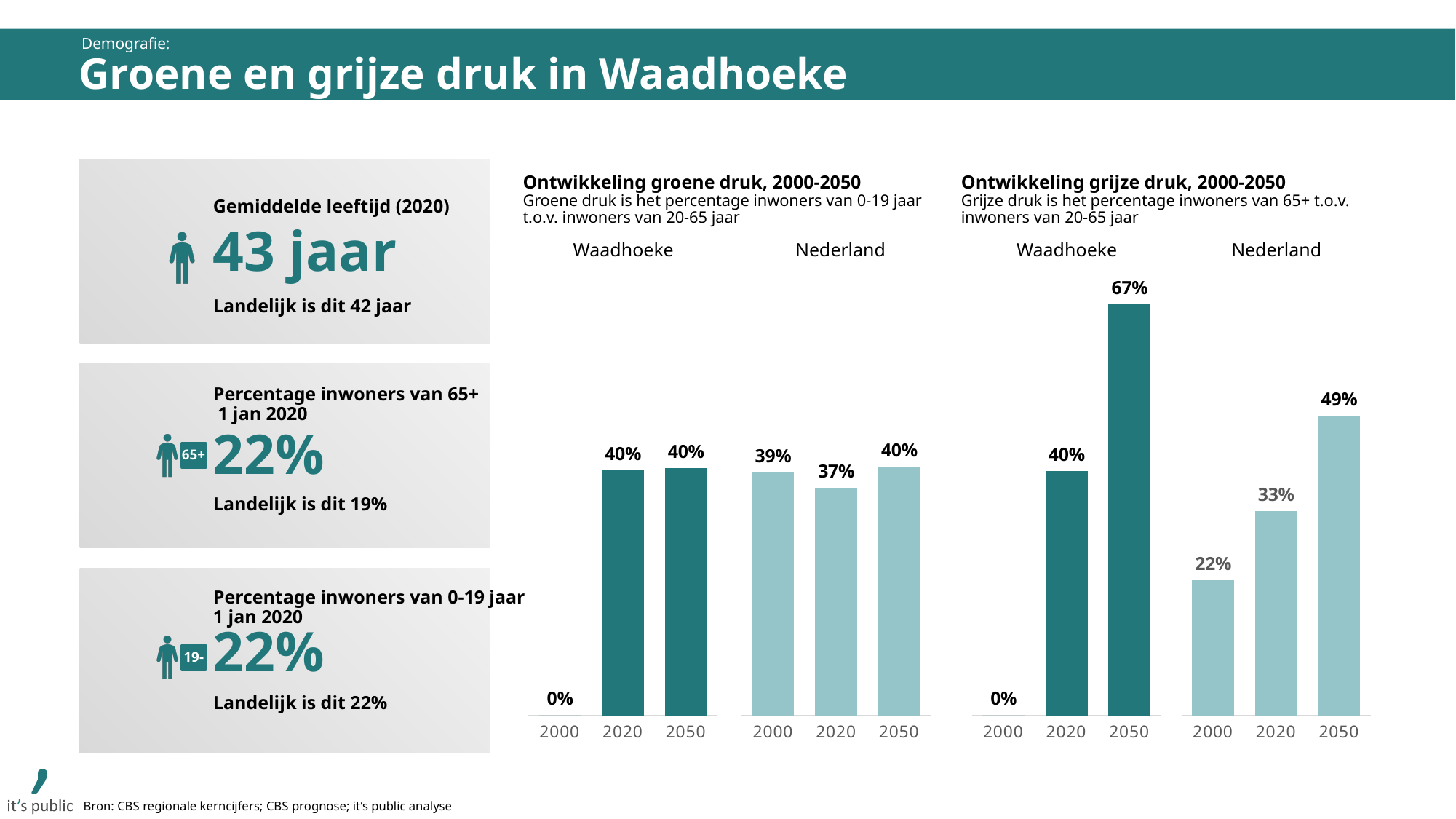
In the 'Ontwikkeling groene druk, 2000-2050' chart, which Nederland year has the lowest value? 2020 In the 'Ontwikkeling grijze druk, 2000-2050' chart, what is the value for Waadhoeke in 2050? 67% In the 'Ontwikkeling groene druk, 2000-2050' chart, what is the value for Waadhoeke in 2020? 40% In the 'Ontwikkeling grijze druk, 2000-2050' chart, what is the value for Nederland in 2000? 22% In the 'Ontwikkeling grijze druk, 2000-2050' chart, which is larger in 2020: Waadhoeke or Nederland? Waadhoeke In the 'Ontwikkeling grijze druk, 2000-2050' chart, do the Nederland values rise or fall from 2000 to 2050? rise In the 'Ontwikkeling groene druk, 2000-2050' chart, what is the value for Nederland in 2020? 37% In the 'Ontwikkeling grijze druk, 2000-2050' chart, what is the difference between Waadhoeke and Nederland in 2050? 18% How many bars are plotted in the 'Ontwikkeling groene druk, 2000-2050' chart, including the 0% bars? 6 What kind of chart is 'Ontwikkeling groene druk, 2000-2050'? bar chart In the 'Ontwikkeling grijze druk, 2000-2050' chart, what is the difference between Nederland in 2050 and Nederland in 2000? 27% In the 'Ontwikkeling grijze druk, 2000-2050' chart, which bar has the highest value? Waadhoeke 2050